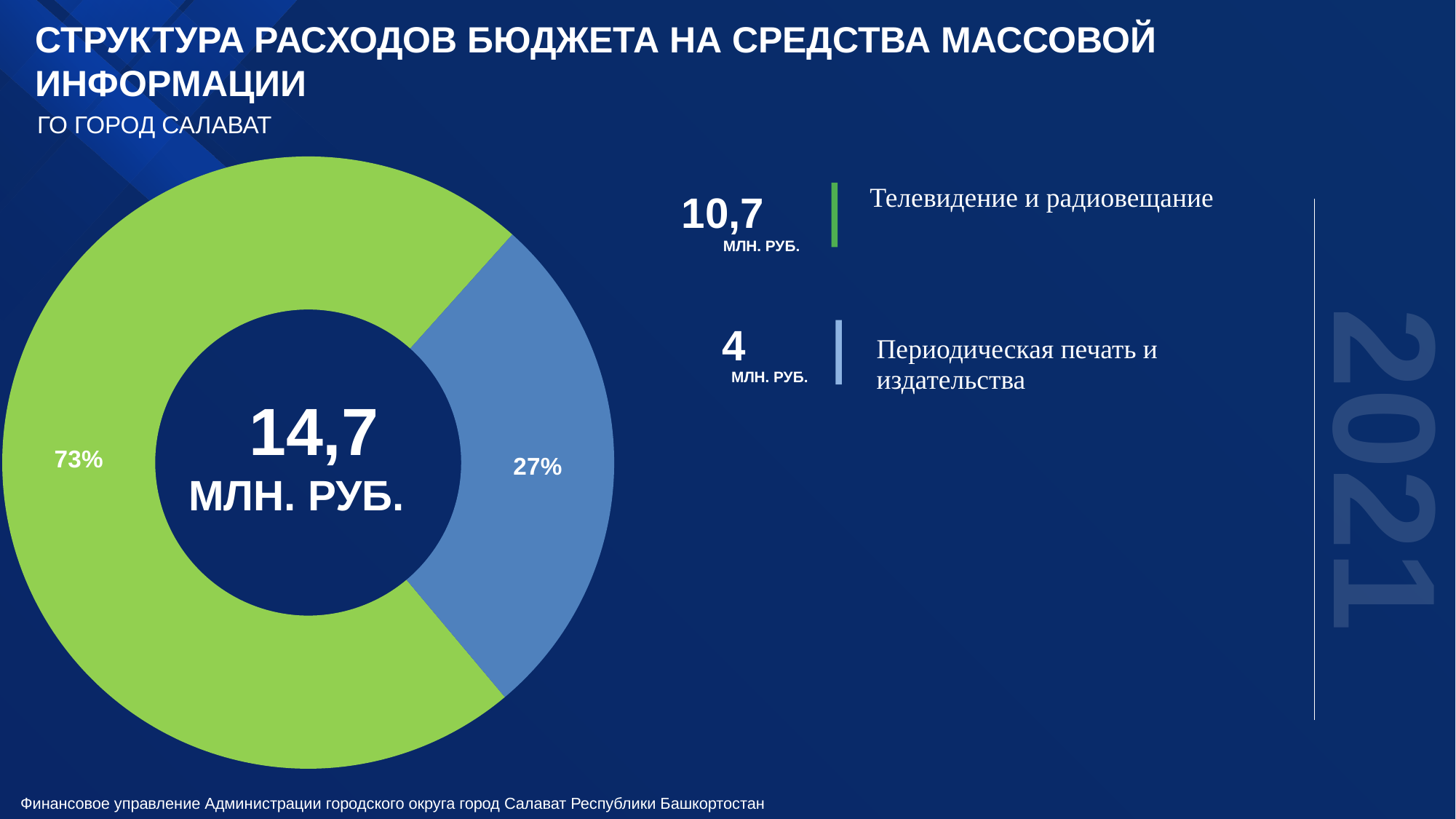
Which category has the smallest share of the chart? Периодическая печать и издательства Which is larger: the value for Телевидение и радиовещание or for Периодическая печать и издательства? Телевидение и радиовещание What is the value shown for Периодическая печать и издательства? 4 млн. руб. What is the difference in percentage points between the 73% slice and the 27% slice? 46 percentage points What kind of chart is shown on the slide? Pie chart (donut) What is the value shown for Телевидение и радиовещание? 10,7 млн. руб. What colour is the slice for Периодическая печать и издательства? Blue What is the total value shown in the centre of the donut chart? 14,7 млн. руб. Which category has the largest share of the chart? Телевидение и радиовещание What share of the chart does the blue slice (Периодическая печать и издательства) represent? 27% What share of the chart does the green slice (Телевидение и радиовещание) represent? 73% How many slices does the donut chart have? 2